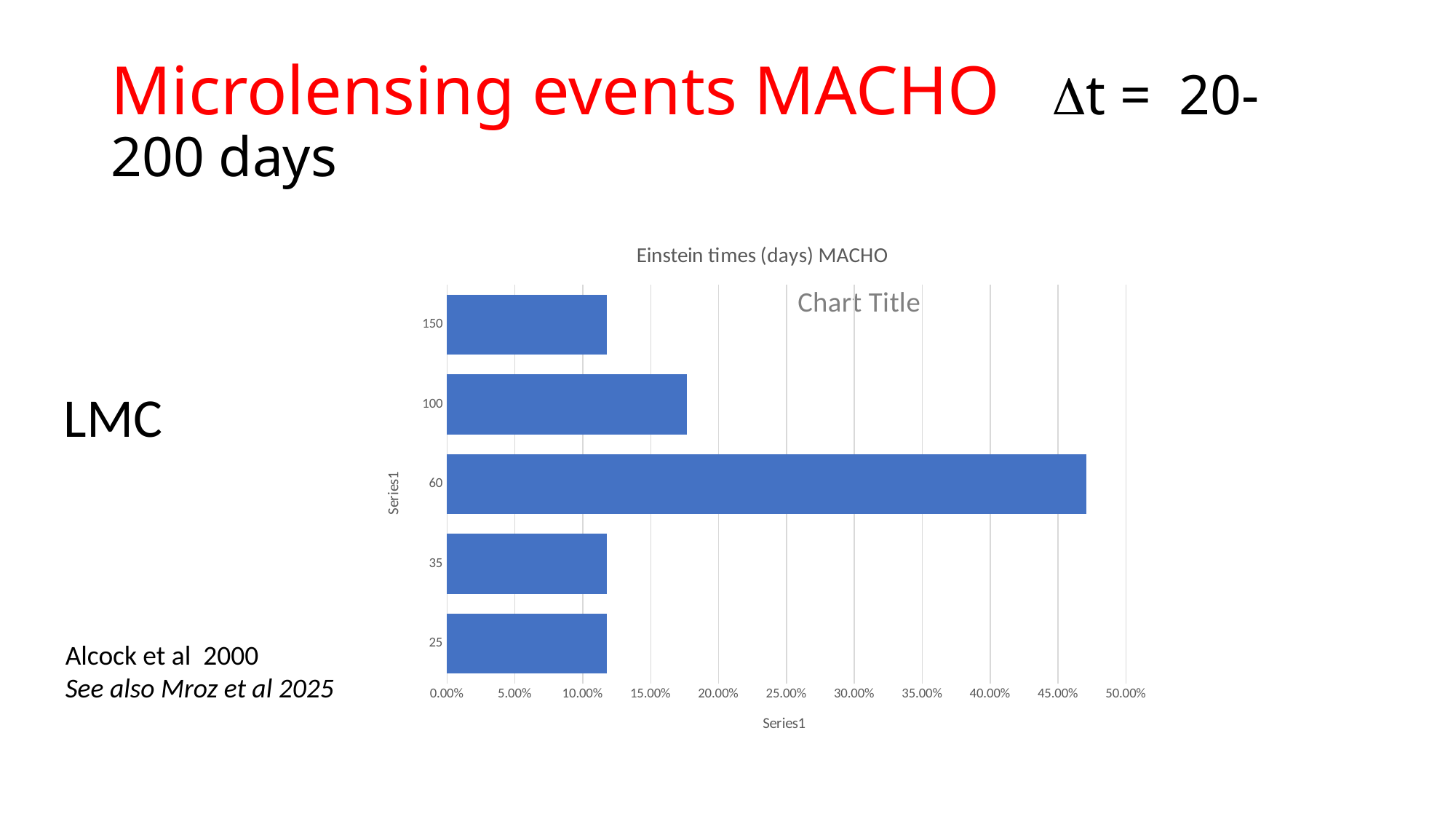
Is the value for category 60 greater or less than 45%? greater What label appears on the horizontal axis of the chart? Series1 Which category has the highest value in the chart? 60 Is the value for category 35 greater or less than 20%? less Which has the larger value, category 60 or category 100? 60 What kind of chart is shown on the slide? bar chart Which has the larger value, category 100 or category 150? 100 Is the value for category 25 greater or less than 15%? less What is the title shown above the chart? Einstein times (days) MACHO How many categories (bars) does the chart show? 5